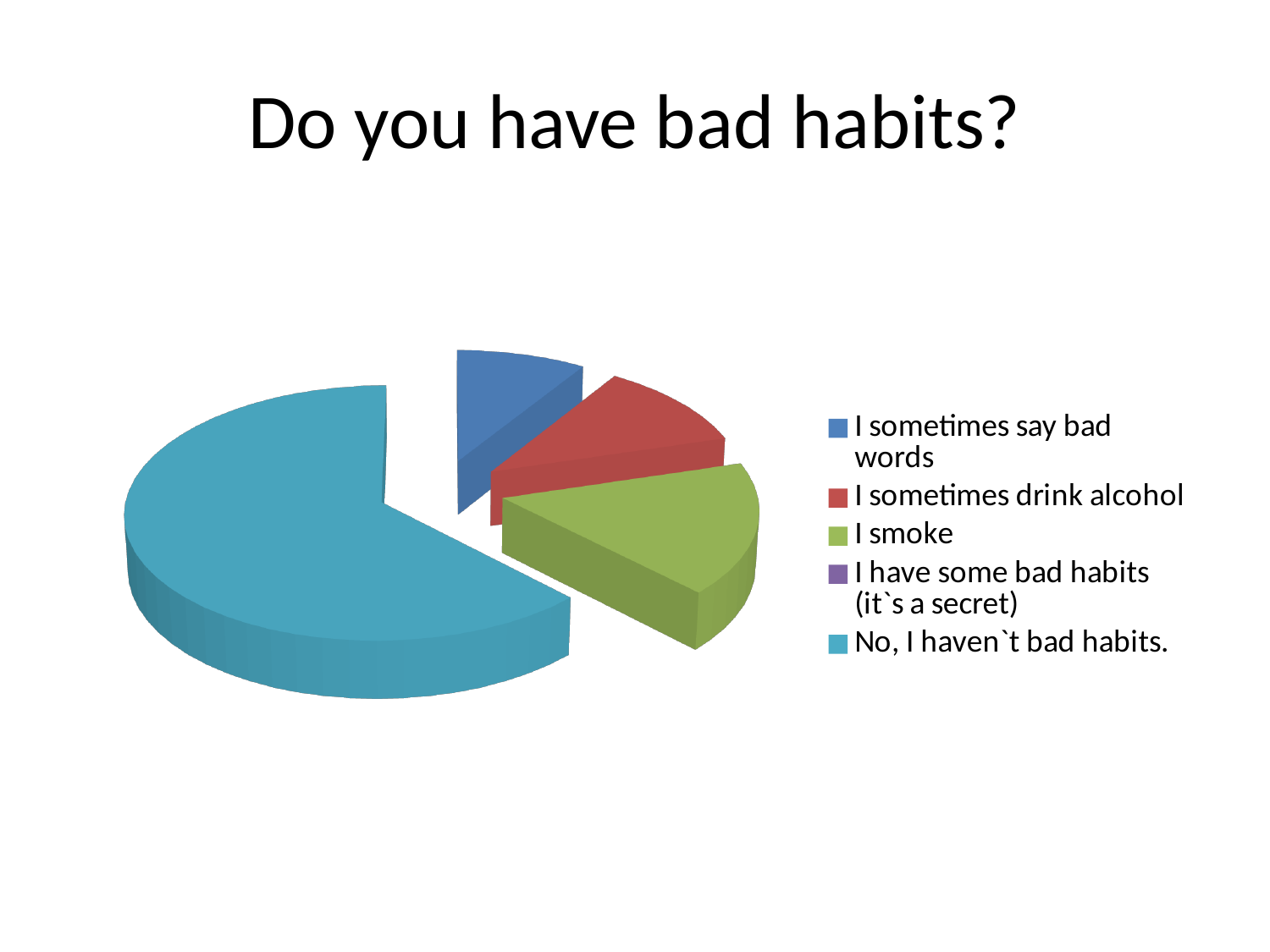
What is the title of the chart on the slide? Do you have bad habits? Which slice is larger: "No, I haven`t bad habits." or "I sometimes drink alcohol"? No, I haven`t bad habits. What colour is the slice for "I smoke"? green Which slice is larger: "I smoke" or "I sometimes say bad words"? I smoke Which category has the largest slice of the pie? No, I haven`t bad habits. What kind of chart is shown on the slide? pie chart Which slice is larger: "I smoke" or "I sometimes drink alcohol"? I smoke How many entries does the chart's legend list? 5